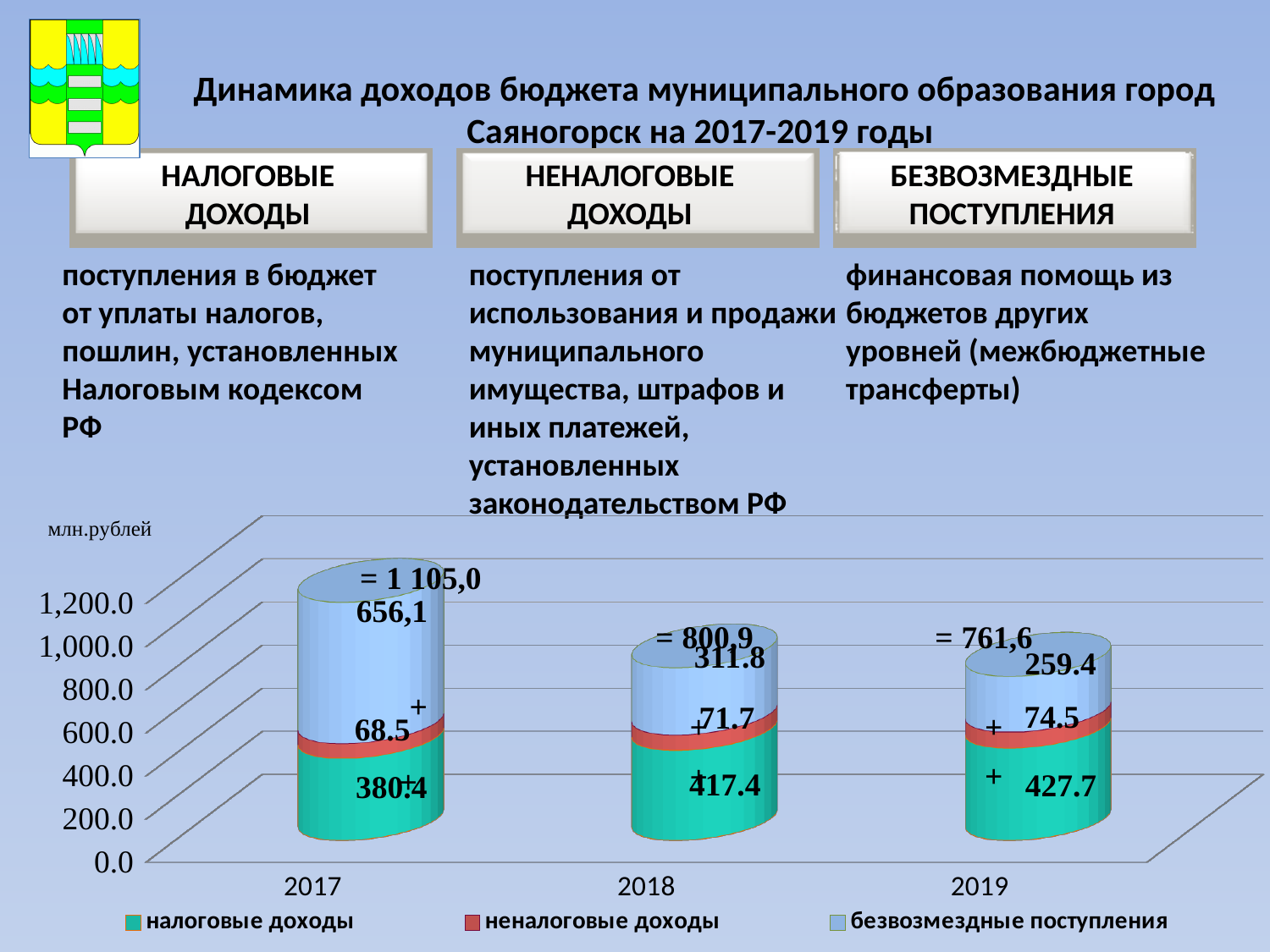
Which is larger: неналоговые доходы in 2019 or in 2017? 2019 How many years are shown on the x axis of the chart? 3 What is the value of неналоговые доходы for 2018? 71.7 What is the total shown for the 2019 stacked bar? 761,6 How many series does the chart legend list? 3 What is the value of налоговые доходы for 2017? 380.4 Which year has the lowest value for налоговые доходы? 2017 What is the difference between налоговые доходы in 2019 and in 2018? 10.3 Do the values for безвозмездные поступления rise or fall from 2017 to 2019? fall Which year has the highest value for безвозмездные поступления? 2017 What is the total shown for the 2017 stacked bar? 1 105,0 What is the value of безвозмездные поступления for 2019? 259.4